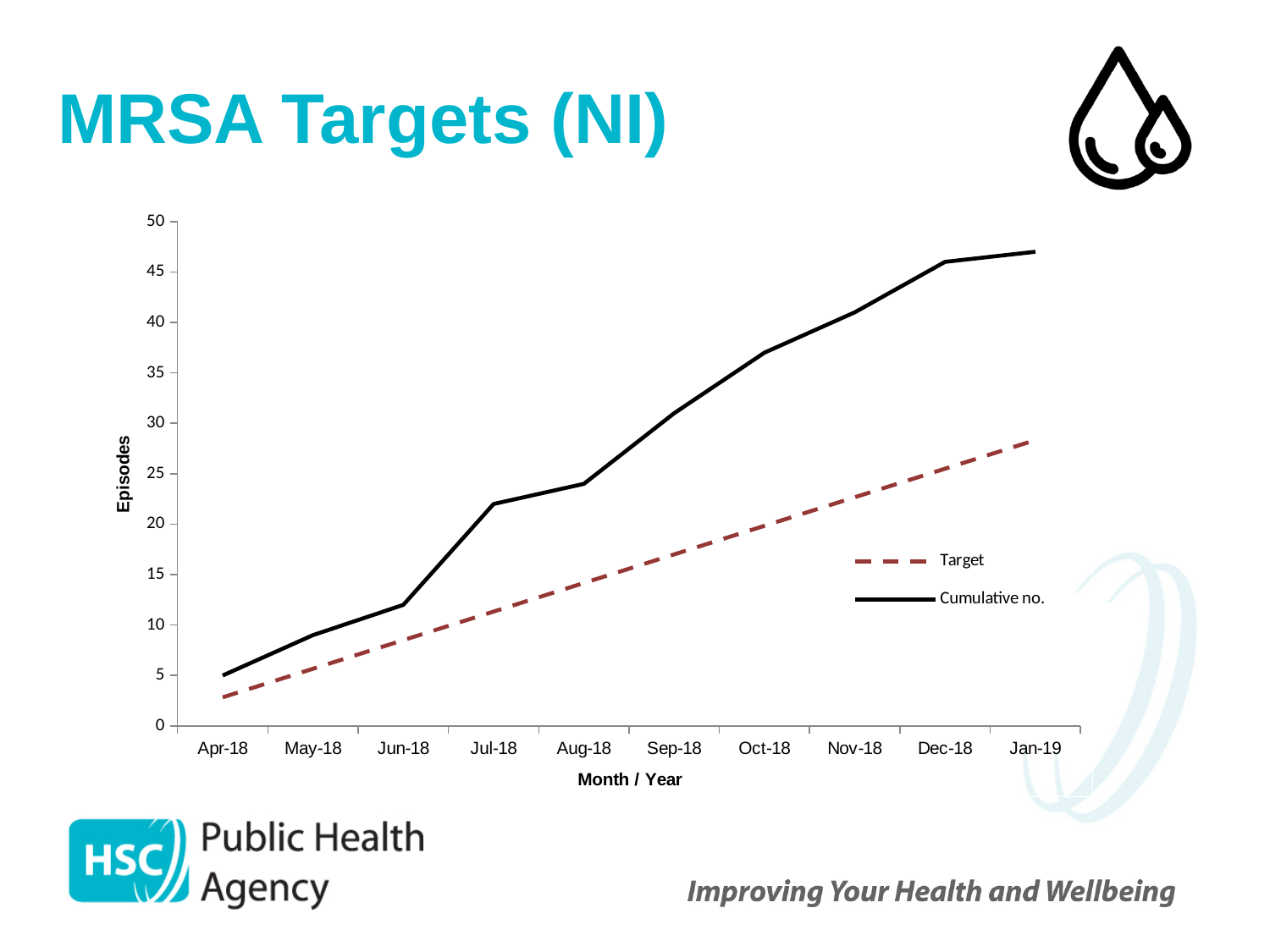
Is the Cumulative no. value for Oct-18 greater or less than 35? greater Is the Target value for Jan-19 greater or less than 30? less Does the Cumulative no. line rise or fall from Apr-18 to Jan-19? rise Which series is drawn with a dashed line? Target What kind of chart is shown on the slide? line chart Is the Cumulative no. value for Jan-19 greater or less than 45? greater What is the label on the y axis? Episodes In Dec-18, which is larger: the Target value or the Cumulative no. value? Cumulative no. How many series does the legend list? 2 How many months are shown along the x axis? 10